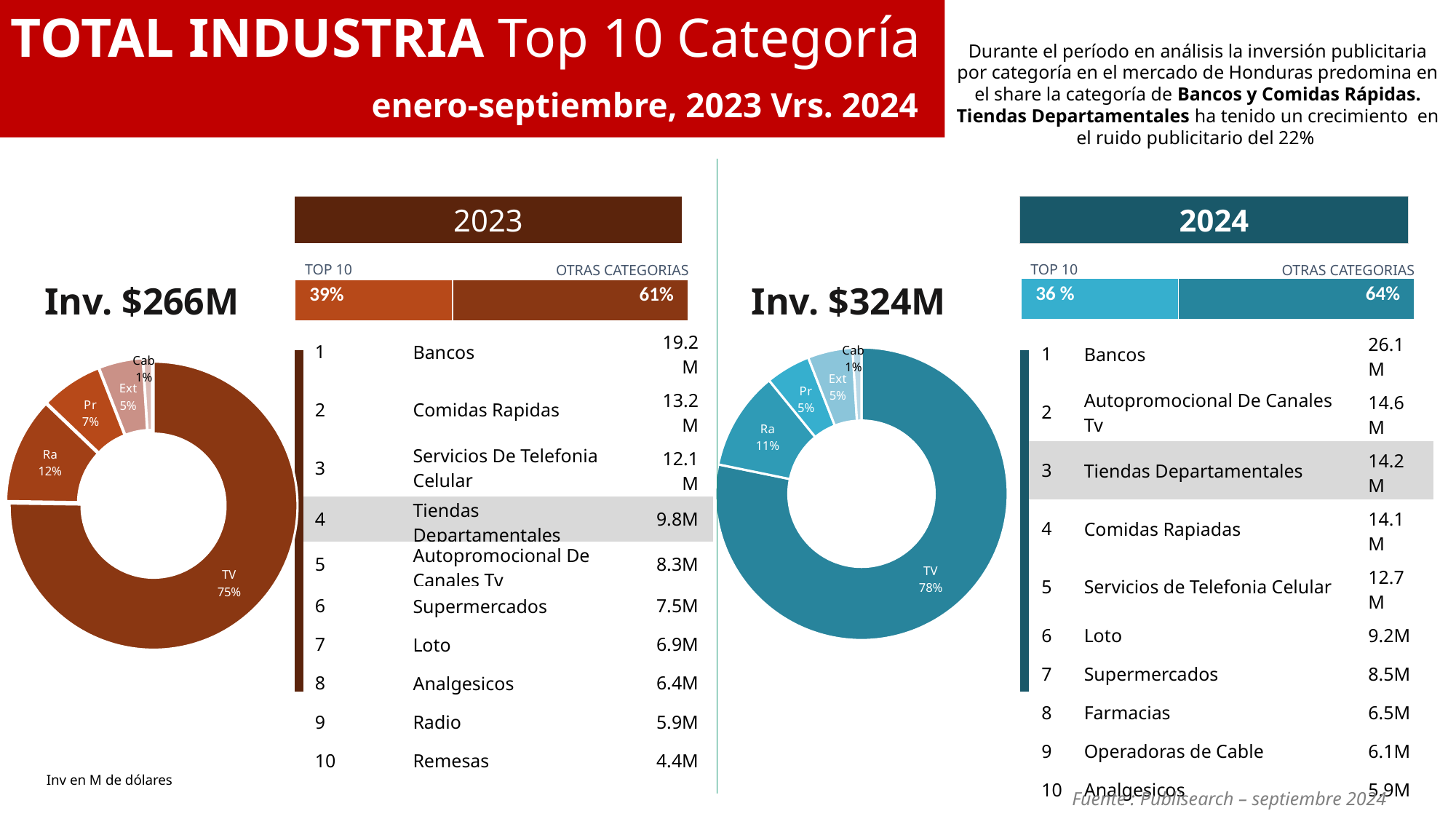
In the 2024 stacked bar, what share is labelled OTRAS CATEGORIAS? 64% In the 2023 stacked bar, what share is labelled TOP 10? 39% In the 2024 donut chart (right), what share does Ra have? 11% In the 2024 donut chart (right), what share does TV have? 78% In the 2023 donut chart (left), which slice is the largest? TV What kind of chart is used to show the media shares under Inv. $266M and Inv. $324M? Donut (pie) chart In the 2023 donut chart (left), what is the difference between the Ra share and the Pr share? 5 percentage points How many slices does the 2023 donut chart (left) have? 5 By how many percentage points is the TV share in the 2024 donut chart higher than in the 2023 donut chart? 3 percentage points In the 2023 donut chart (left), which is larger, Ra or Pr? Ra In the 2023 donut chart (left), which slice is the smallest? Cab In the 2023 donut chart (left), what share does TV have? 75%